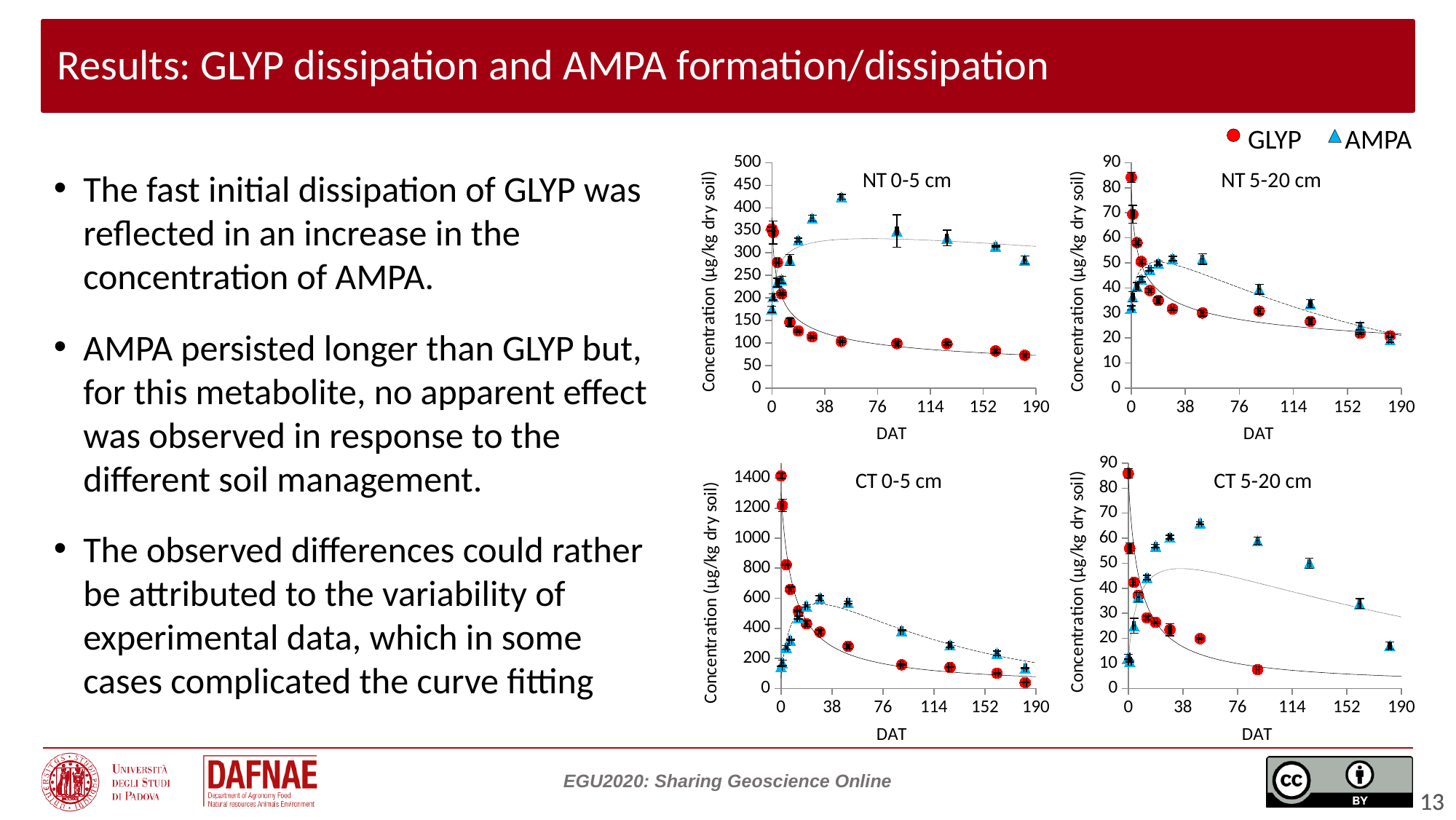
How many charts are shown on the slide? 4 In the CT 0-5 cm chart, is the GLYP value at DAT 0 greater or less than 1200? greater In the CT 5-20 cm chart, is the highest AMPA value greater or less than 60? greater In the NT 0-5 cm chart, at DAT 190, which series has the larger value, GLYP or AMPA? AMPA In the NT 5-20 cm chart, is the GLYP value at DAT 0 greater or less than 80? greater What are the two series named in the legend? GLYP and AMPA In the CT 0-5 cm chart, does the GLYP concentration rise or fall as DAT increases? fall What is the x-axis label of the CT 0-5 cm chart? DAT How many series does the legend list for the charts? 2 What kind of chart is the NT 0-5 cm chart? scatter chart